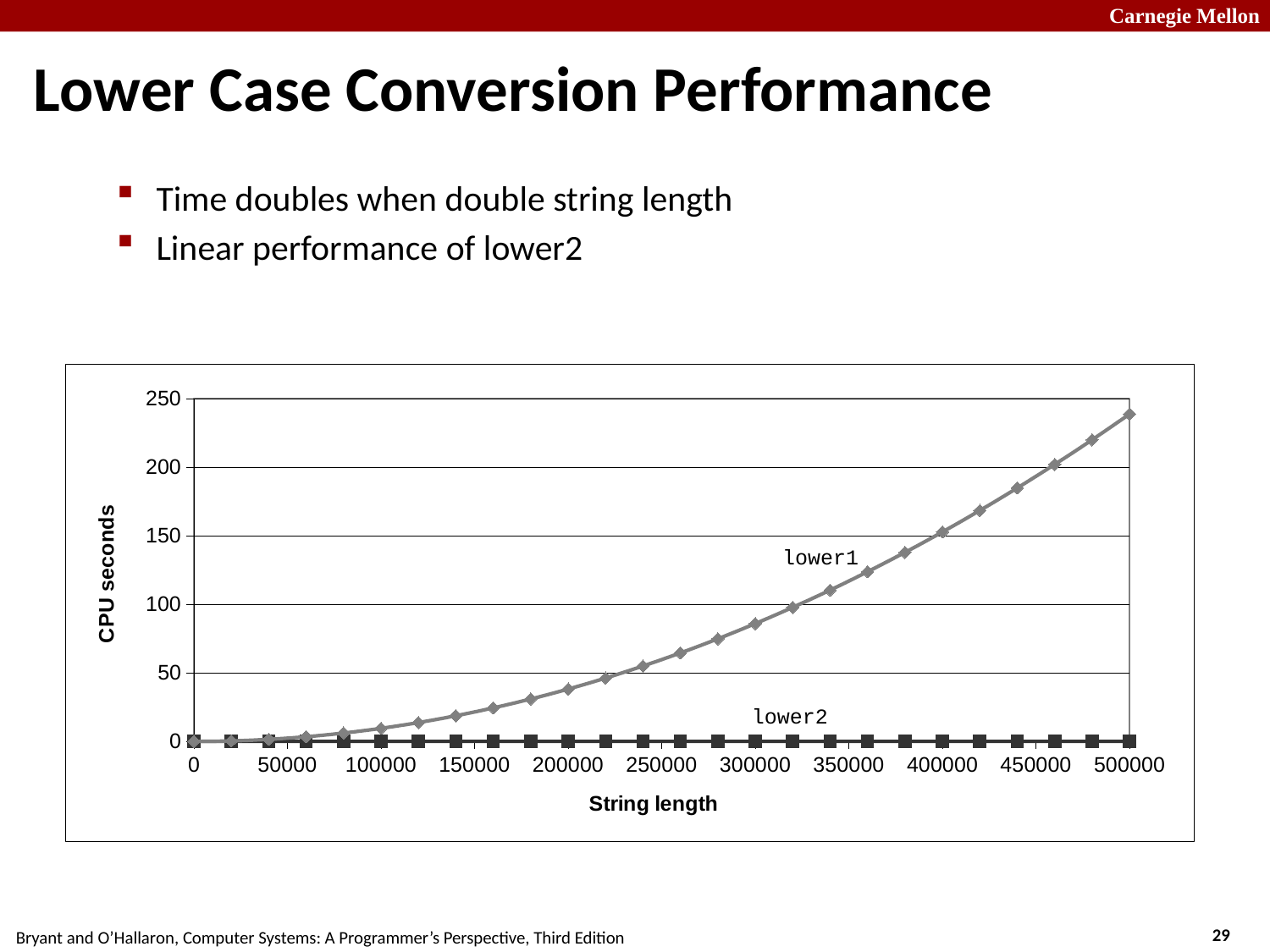
Which series has the larger value at a string length of 400000, lower1 or lower2? lower1 What are the names of the two series plotted on the chart? lower1 and lower2 Is the value for lower1 at a string length of 300000 greater or less than 100? less Is the value for lower1 at a string length of 500000 greater or less than 200? greater What is the label of the y axis? CPU seconds What kind of chart is shown on the slide? line chart Which series stays lowest across all string lengths? lower2 Does the CPU time for lower1 rise or fall as string length increases? rise How many data series are plotted on the chart? 2 Which series reaches the highest CPU seconds on the chart? lower1 Is the value for lower2 at a string length of 500000 greater or less than 50? less